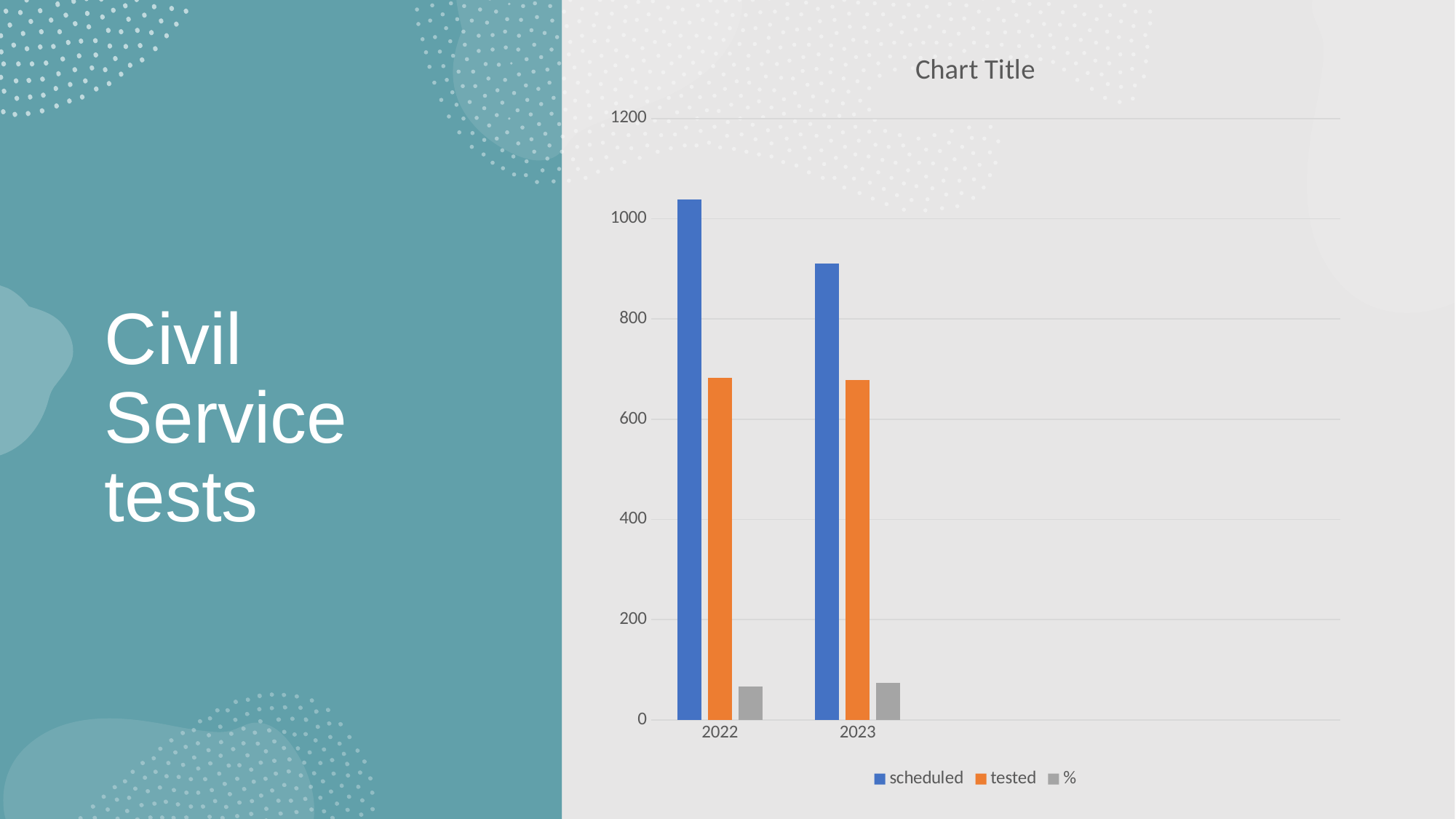
What is the title shown above the chart? Chart Title What kind of chart is shown on the slide? bar chart Is the value for tested in 2023 greater or less than 800? less Is the value for scheduled in 2022 greater or less than 1000? greater Which year has the higher value for scheduled, 2022 or 2023? 2022 Is the value for tested in 2022 greater or less than 600? greater Does the scheduled series rise or fall from 2022 to 2023? fall How many categories are shown on the x axis of the chart? 2 How many series does the chart legend list? 3 Which series has the lowest values in both years? %